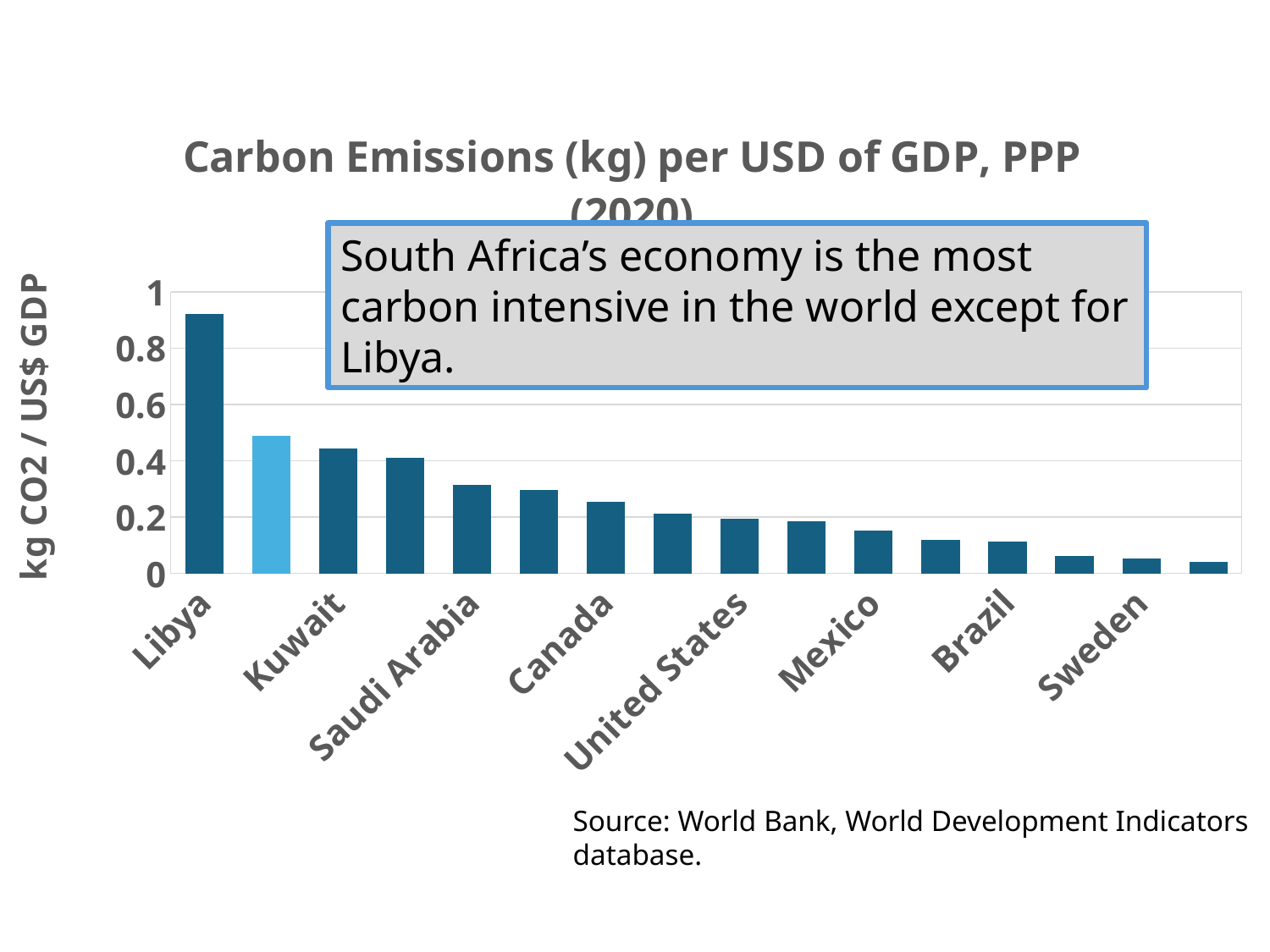
How many bars are plotted in the chart? 16 Which country has the highest carbon emissions per USD of GDP in the chart? Libya Is the value for Sweden greater or less than 0.2? less Is the value for Saudi Arabia greater or less than 0.4? less Is the value for Mexico greater or less than 0.2? less Do the bar values rise or fall moving from left to right along the x axis? Fall What is the title of the chart? Carbon Emissions (kg) per USD of GDP, PPP (2020) What kind of chart is shown on the slide? Bar chart What is the label on the vertical axis of the chart? kg CO2 / US$ GDP Which has a higher value, Kuwait or Brazil? Kuwait